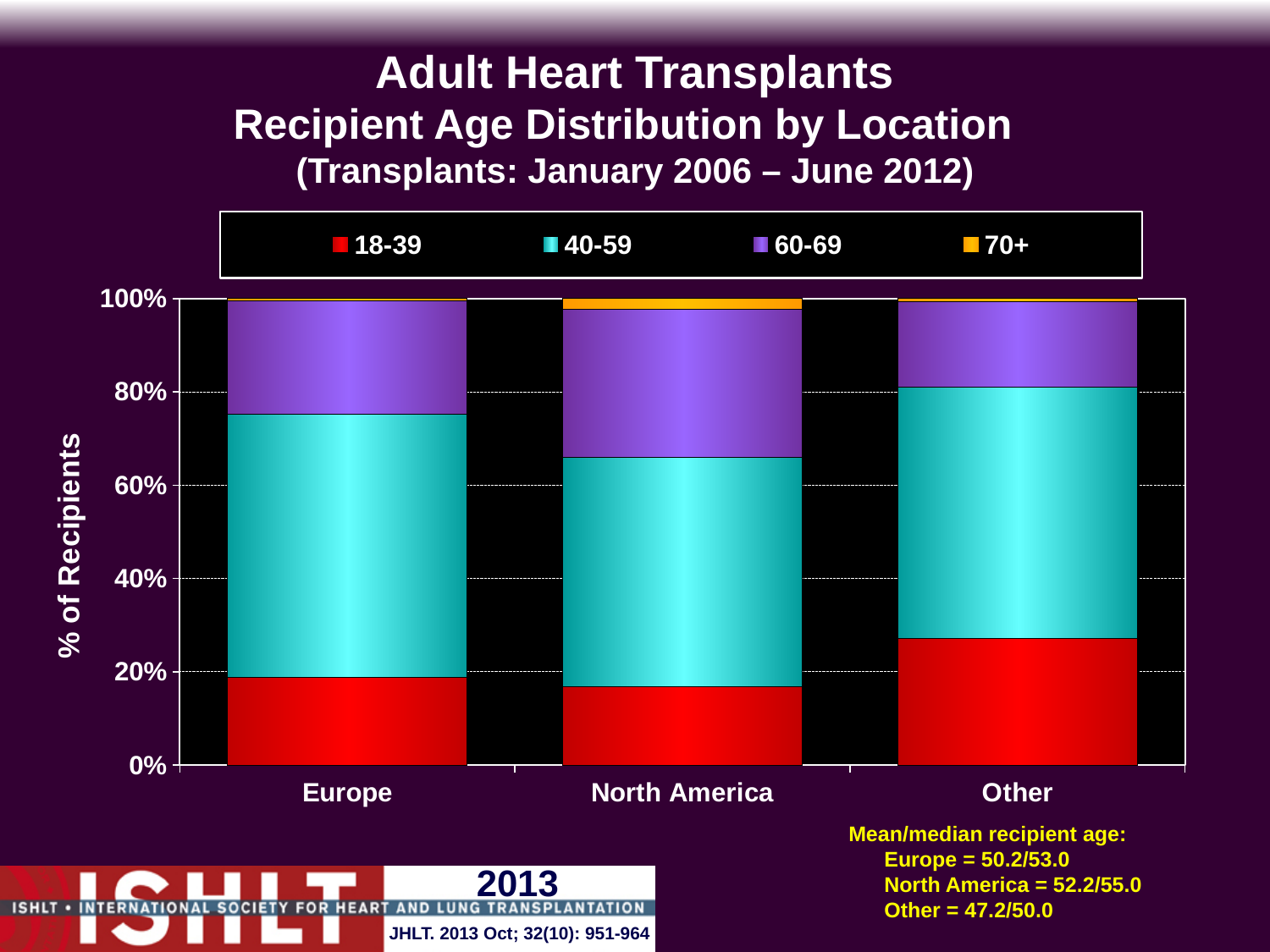
Which location has the largest share of recipients aged 60-69? North America Is the share of recipients aged 60-69 larger in North America or in Other? North America Which location has the smallest share of recipients aged 60-69? Other Is the share of recipients aged 18-39 in Other greater or less than 20%? greater Which location has the largest share of recipients aged 18-39? Other How many locations are shown on the x axis of the chart? 3 How many age groups does the legend list? 4 Is the share of recipients aged 18-39 larger in Other or in North America? Other What is the label on the y axis of the chart? % of Recipients What kind of chart is shown on the slide? stacked bar chart Which location has the smallest share of recipients aged 40-59? North America Is the share of recipients aged 18-39 in North America greater or less than 20%? less